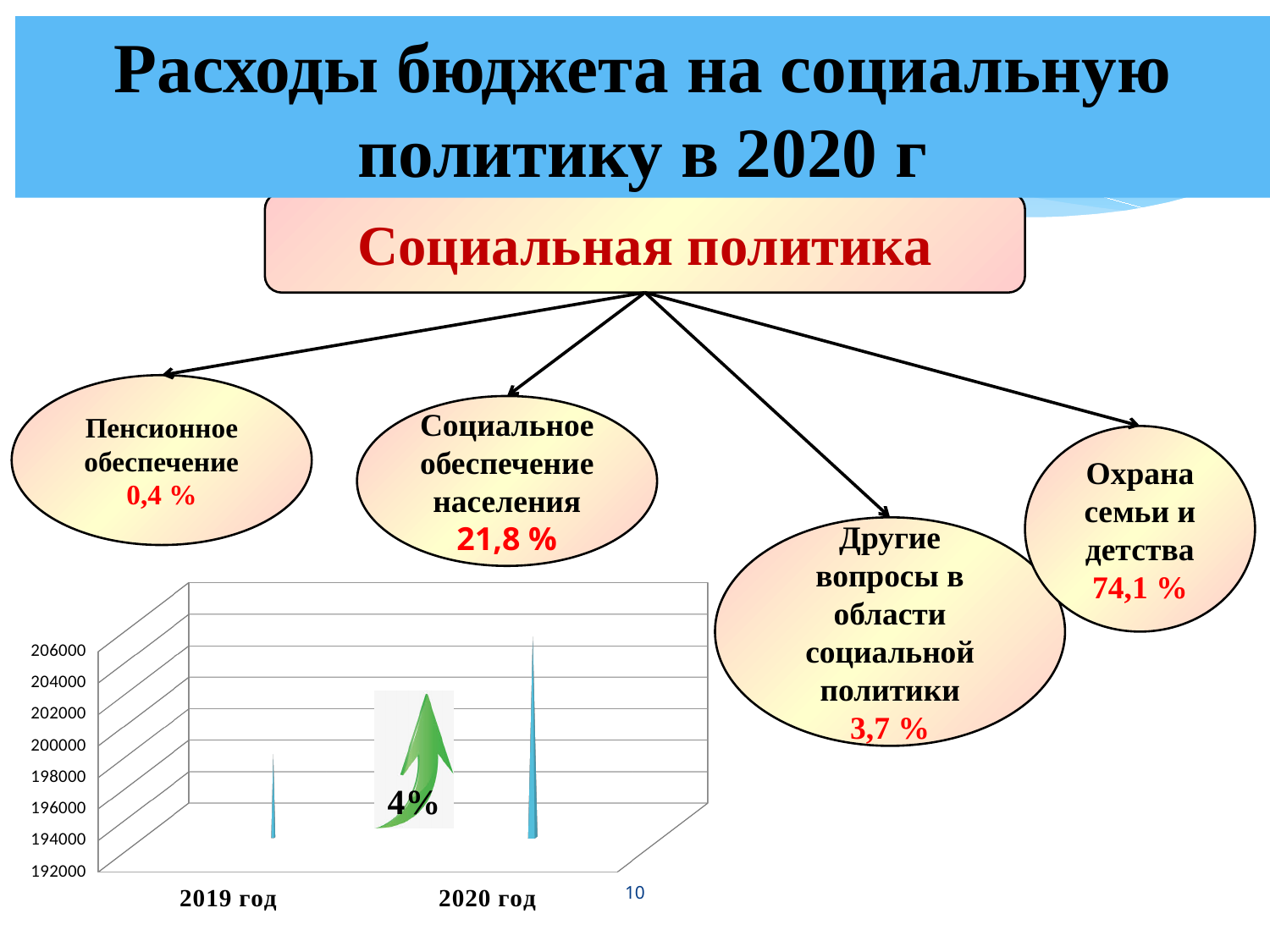
What kind of chart is shown at the bottom left of the slide? bar chart Is the value for 2020 год greater or less than 200000? greater Which year has the higher value in the chart, 2019 год or 2020 год? 2020 год What percentage is written next to the green arrow in the chart? 4% Is the value for 2019 год greater or less than 194000? greater Is the value for 2019 год greater or less than 202000? less How many categories are shown on the x axis of the chart? 2 Do the values in the chart rise or fall from 2019 год to 2020 год? rise Which category has the highest value in the chart? 2020 год What is the highest value labelled on the vertical axis of the chart? 206000 Which category has the lowest value in the chart? 2019 год